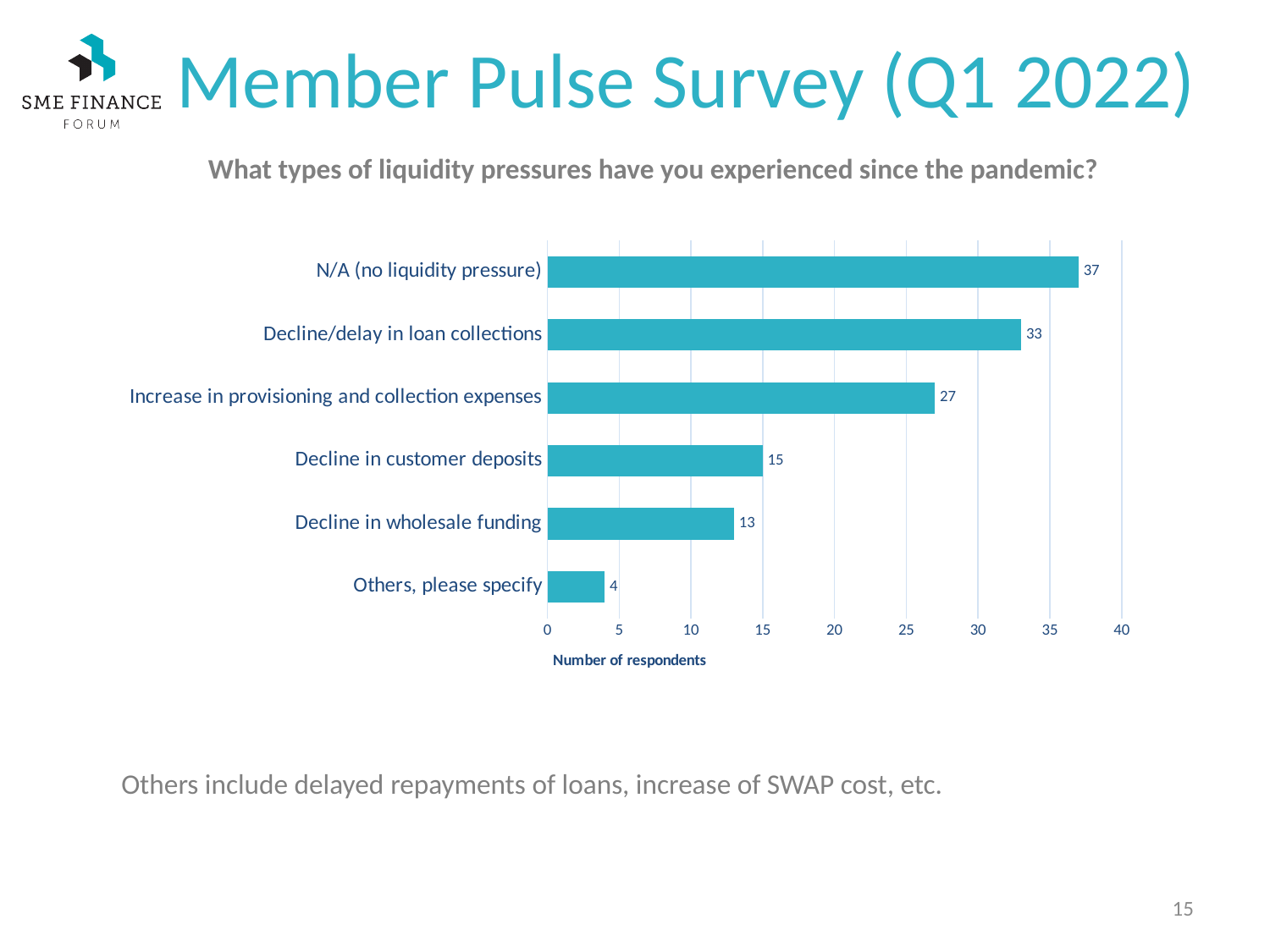
What type of chart is shown on the slide? Bar chart Which category has the highest number of respondents? N/A (no liquidity pressure) How many respondents reported Decline in wholesale funding? 13 Which category has the lowest number of respondents? Others, please specify What is the label of the horizontal axis of the chart? Number of respondents What is the number of respondents for Decline/delay in loan collections? 33 What is the number of respondents for Increase in provisioning and collection expenses? 27 How many categories are shown in the chart? 6 How many respondents reported N/A (no liquidity pressure)? 37 What is the difference in respondents between Decline/delay in loan collections and Decline in customer deposits? 18 Which has more respondents: Decline in customer deposits or Decline in wholesale funding? Decline in customer deposits What question does the chart title ask? What types of liquidity pressures have you experienced since the pandemic?